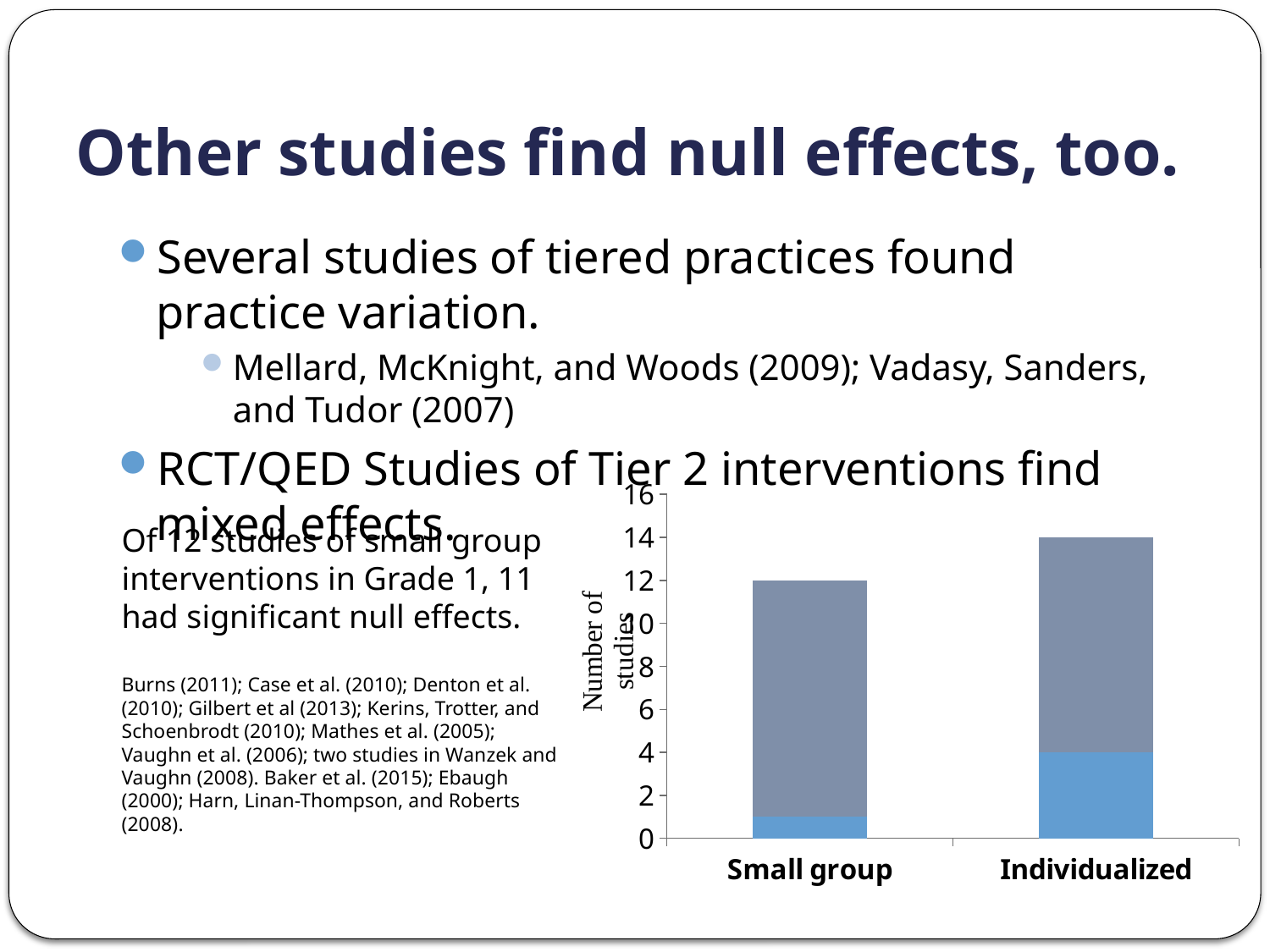
What is the total height of the Small group bar? 12 Which category has the taller bar in the chart? Individualized How many categories are shown on the x axis of the chart? 2 What is the value of the lighter blue bottom segment of the Individualized bar? 4 Which category has the shorter bar in the chart? Small group What is the highest tick value shown on the chart's y axis? 16 What is the total height of the Individualized bar? 14 What kind of chart is shown on the slide? Stacked bar chart Is the lighter blue bottom segment of the Small group bar greater or less than 2? less What is the title of the chart's y axis? Number of studies Is the total for Individualized larger or smaller than the total for Small group? Larger What is the difference between the total heights of the Individualized and Small group bars? 2